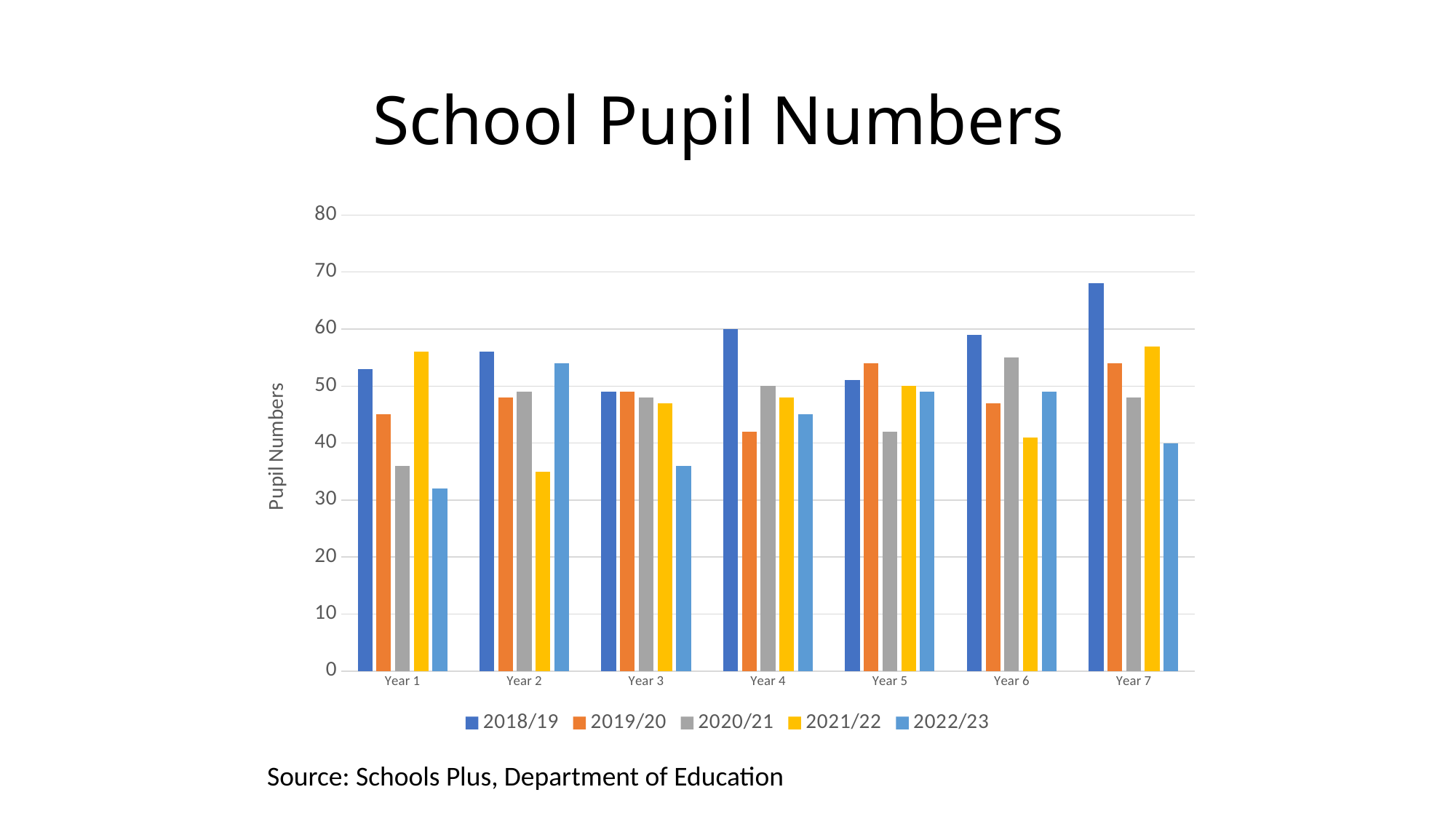
For Year 6, which is larger: the 2020/21 value or the 2021/22 value? 2020/21 What is the label on the vertical axis? Pupil Numbers What kind of chart is shown on the slide? bar chart Which year group has the highest 2018/19 bar? Year 7 How many series does the legend list? 5 Is the 2018/19 value for Year 6 greater or less than 50? greater For Year 1, which is larger: the 2018/19 value or the 2019/20 value? 2018/19 Which year group has the lowest 2021/22 bar? Year 2 Is the 2022/23 value for Year 1 greater or less than 40? less Is the 2018/19 value for Year 7 greater or less than 60? greater How many year groups are shown on the x axis? 7 Which year group has the lowest 2022/23 bar? Year 1